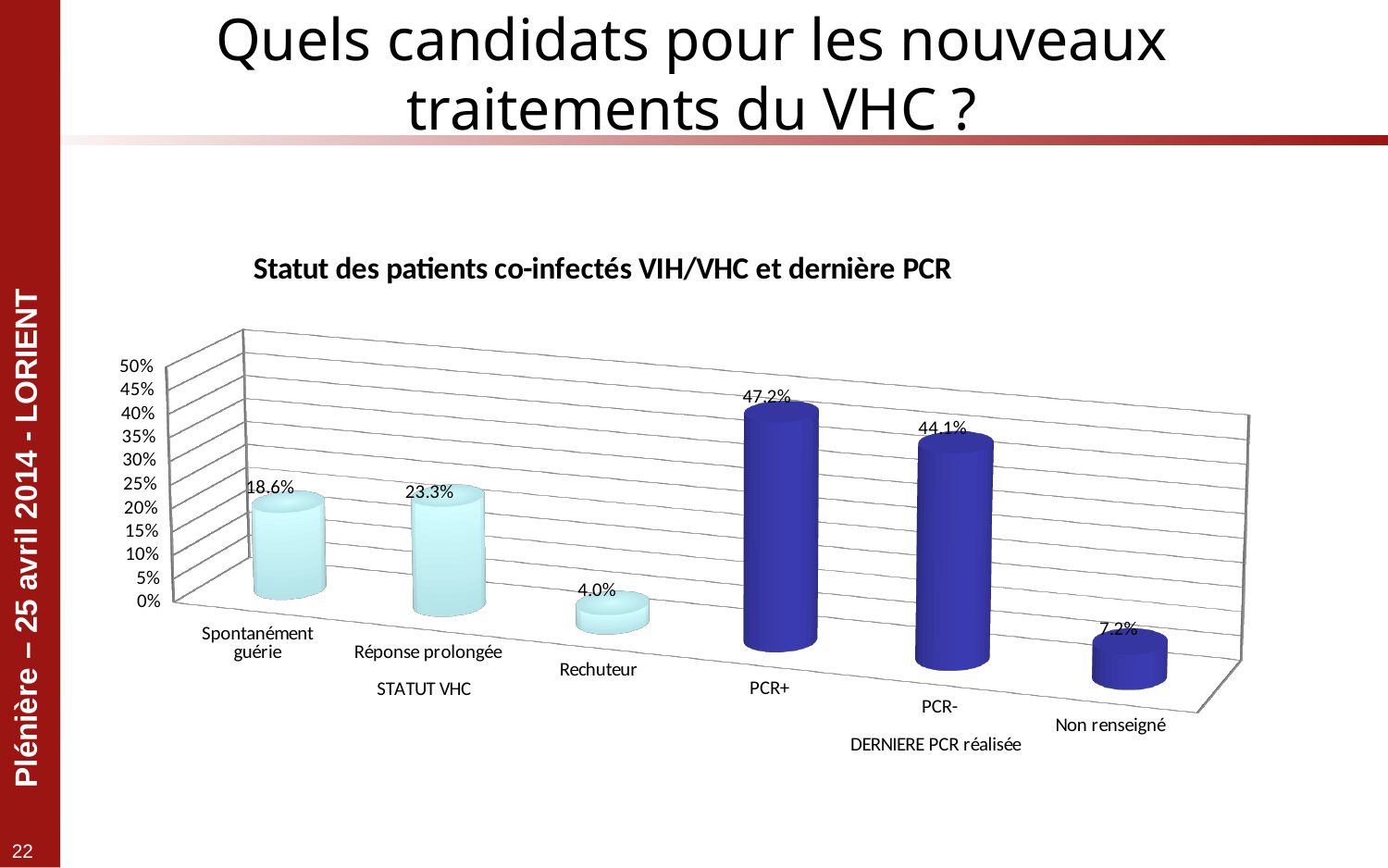
How many categories are shown in the chart? 6 What is the value for Rechuteur? 4.0% What is the title of the chart? Statut des patients co-infectés VIH/VHC et dernière PCR What is the difference between the values for Réponse prolongée and Spontanément guérie? 4.7% Which category has the lowest value? Rechuteur What is the value for PCR+? 47.2% Which is larger, the value for Spontanément guérie or the value for Réponse prolongée? Réponse prolongée What is the value for Non renseigné? 7.2% What kind of chart is shown on the slide? Bar chart Which category has the highest value? PCR+ What is the value for Réponse prolongée? 23.3% What is the difference between the values for PCR+ and PCR-? 3.1%